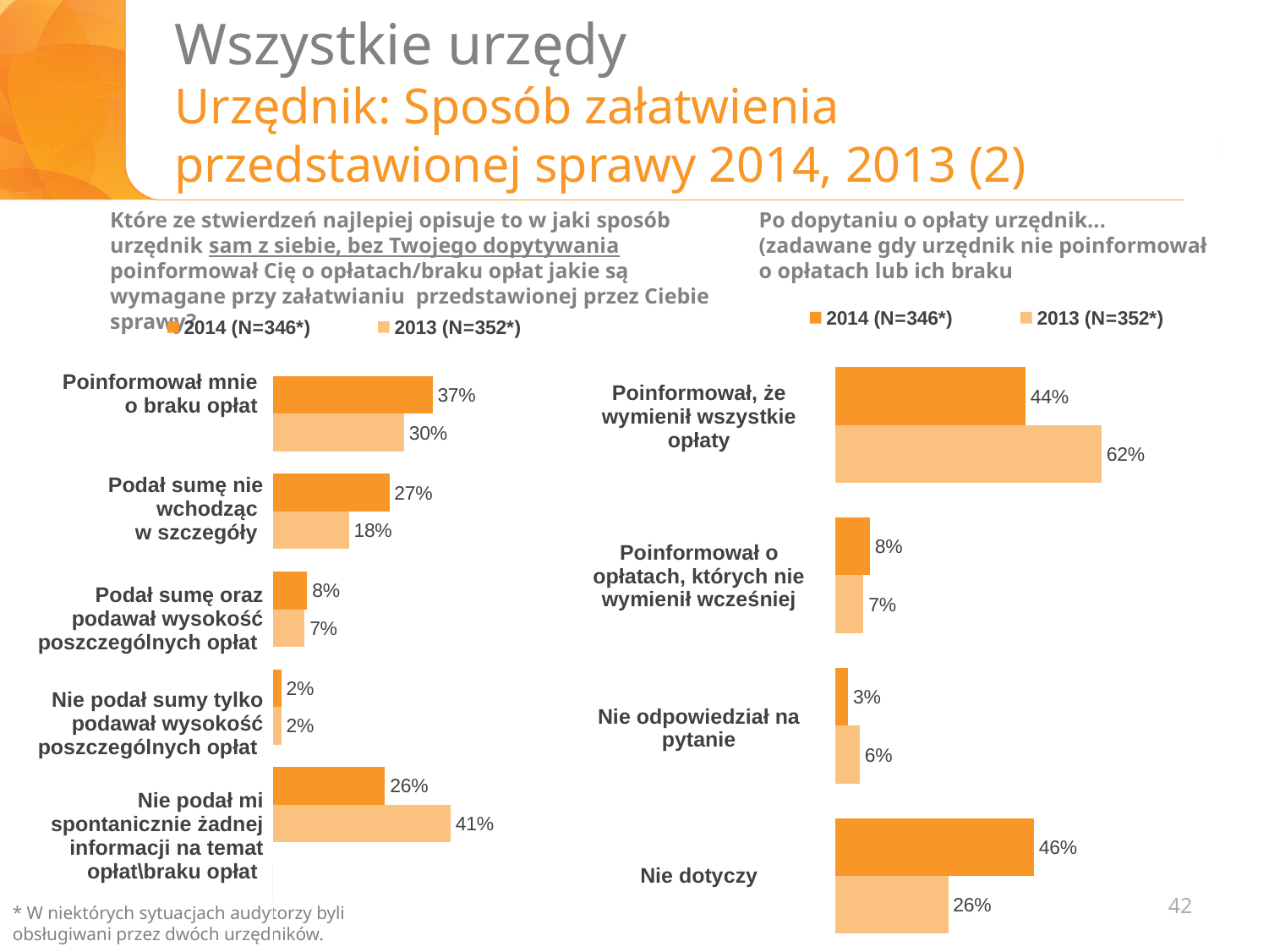
In the left chart, which is larger for "Podał sumę nie wchodząc w szczegóły": the 2014 value or the 2013 value? 2014 In the left chart, what is the 2013 value for "Nie podał mi spontanicznie żadnej informacji na temat opłat\braku opłat"? 41% In the right chart, what is the 2013 value for "Poinformował, że wymienił wszystkie opłaty"? 62% In the right chart, what is the difference between the 2013 and 2014 values for "Poinformował, że wymienił wszystkie opłaty"? 18% How many categories does the right chart show? 4 What type of chart is the left chart? Bar chart In the left chart, what is the 2014 value for "Poinformował mnie o braku opłat"? 37% In the left chart, which category has the highest 2014 value? Poinformował mnie o braku opłat In the right chart, which category has the lowest 2014 value? Nie odpowiedział na pytanie How many series does the legend of the left chart list? 2 In the right chart, what is the 2014 value for "Nie dotyczy"? 46% In the left chart, what is the difference between the 2013 and 2014 values for "Nie podał mi spontanicznie żadnej informacji na temat opłat\braku opłat"? 15%